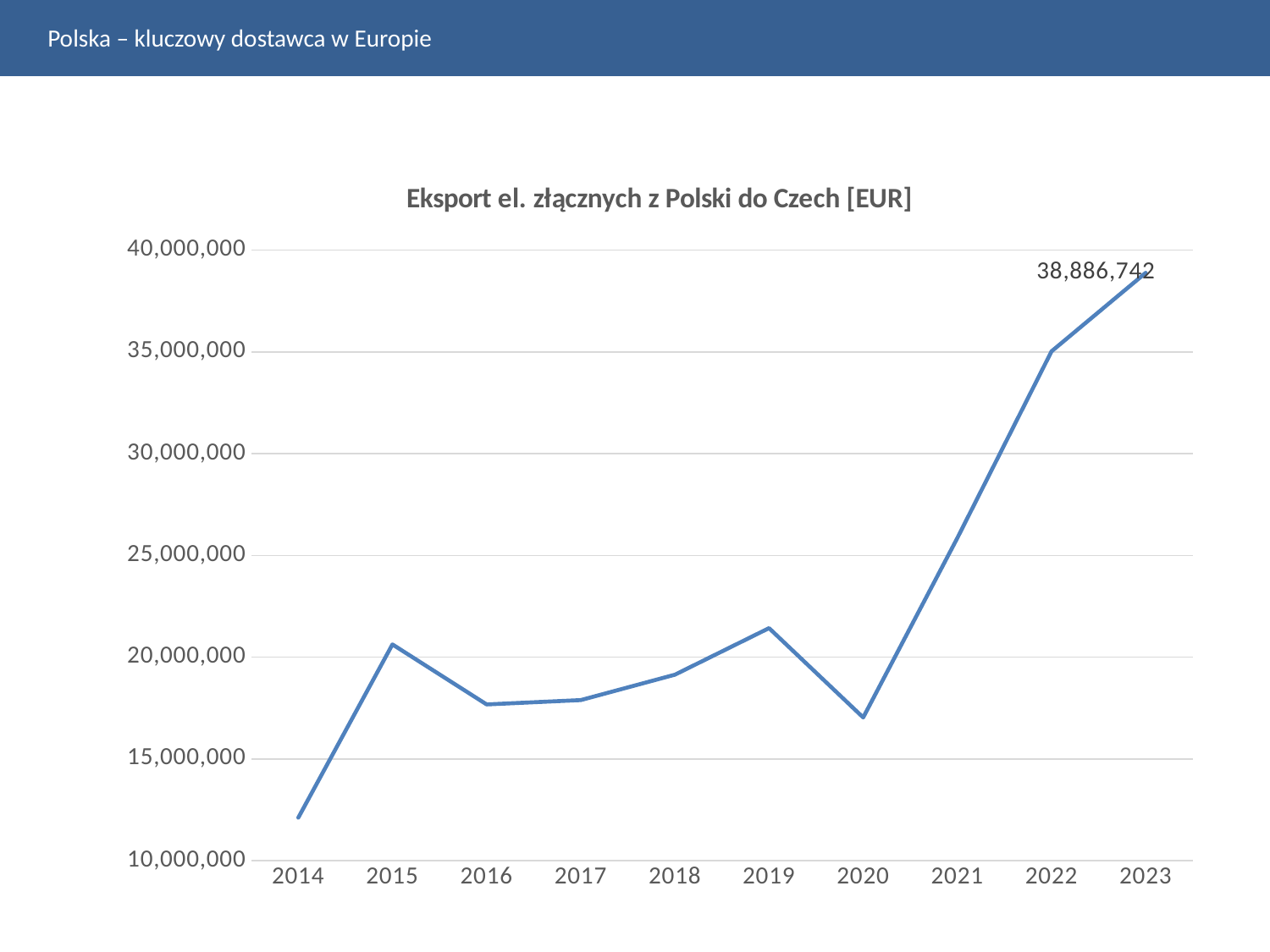
Is the value for 2014 greater or less than 15,000,000? less Is the value for 2019 greater or less than 20,000,000? greater Which is larger, the value for 2015 or the value for 2016? 2015 Is the value for 2021 greater or less than 25,000,000? greater Which year has the highest value? 2023 What type of chart is shown on the slide? line chart What is the title of the chart? Eksport el. złącznych z Polski do Czech [EUR] Does the value rise or fall from 2020 to 2023? rise Which year has the lowest value? 2014 How many years are plotted on the x axis? 10 What is the value for 2023? 38,886,742